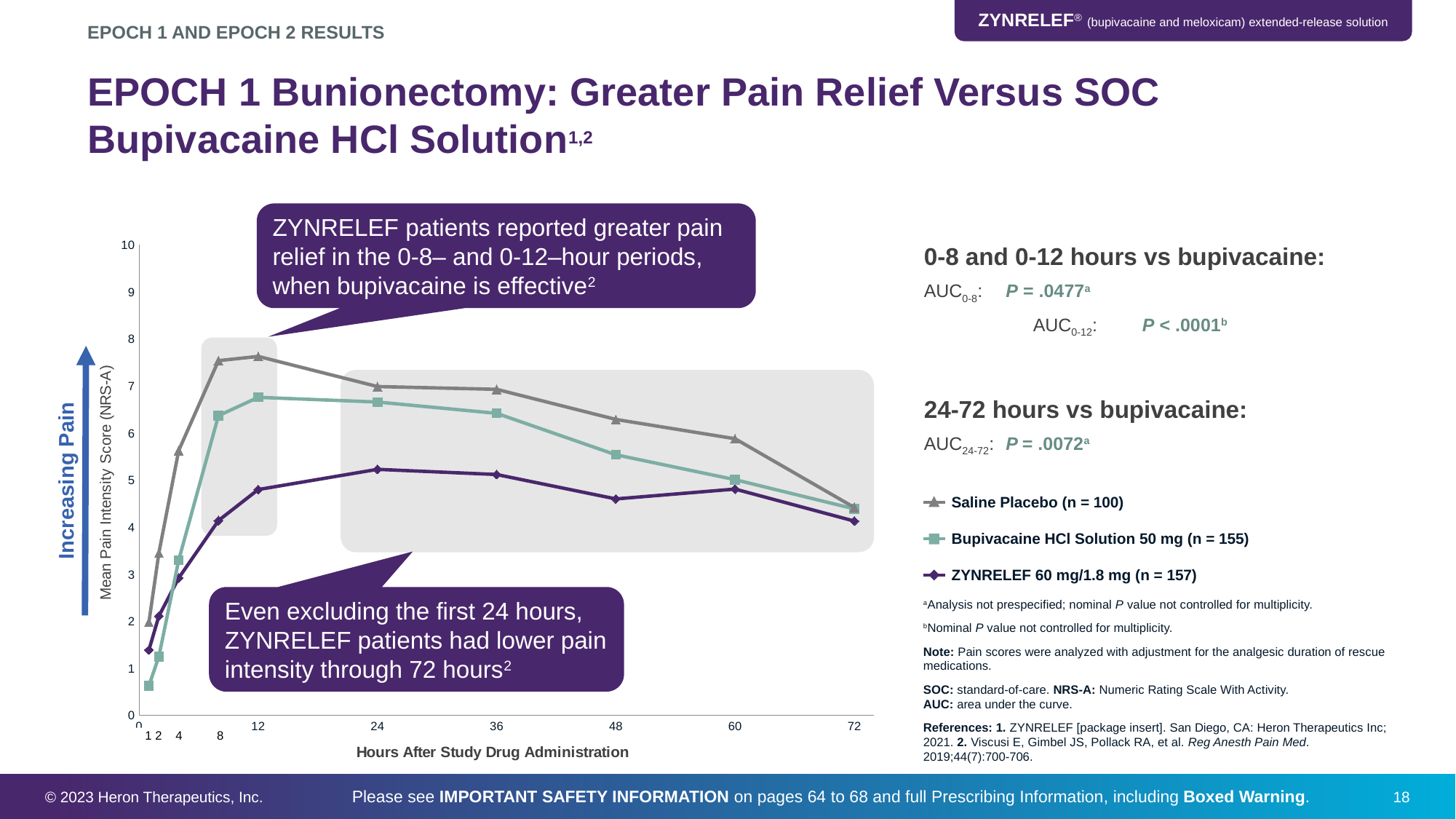
Which series has the highest mean pain intensity score at 8 hours? Saline Placebo (n = 100) What kind of chart is shown on the slide? Line chart At 12 hours, which series has the higher mean pain intensity score: Saline Placebo or ZYNRELEF 60 mg/1.8 mg? Saline Placebo Which series has the lowest mean pain intensity score at 24 hours? ZYNRELEF 60 mg/1.8 mg (n = 157) Does the mean pain intensity score for Saline Placebo rise or fall from 12 hours to 72 hours? fall How many series does the chart legend list? 3 Is the mean pain intensity score for ZYNRELEF 60 mg/1.8 mg at 72 hours greater or less than 5? less At 36 hours, which series has the higher mean pain intensity score: Bupivacaine HCl Solution 50 mg or ZYNRELEF 60 mg/1.8 mg? Bupivacaine HCl Solution 50 mg Is the mean pain intensity score for Bupivacaine HCl Solution 50 mg at 48 hours greater or less than 6? less What is the title of the y axis of the chart? Mean Pain Intensity Score (NRS-A) What is the title of the x axis of the chart? Hours After Study Drug Administration Is the mean pain intensity score for Saline Placebo at 12 hours greater or less than 7? greater